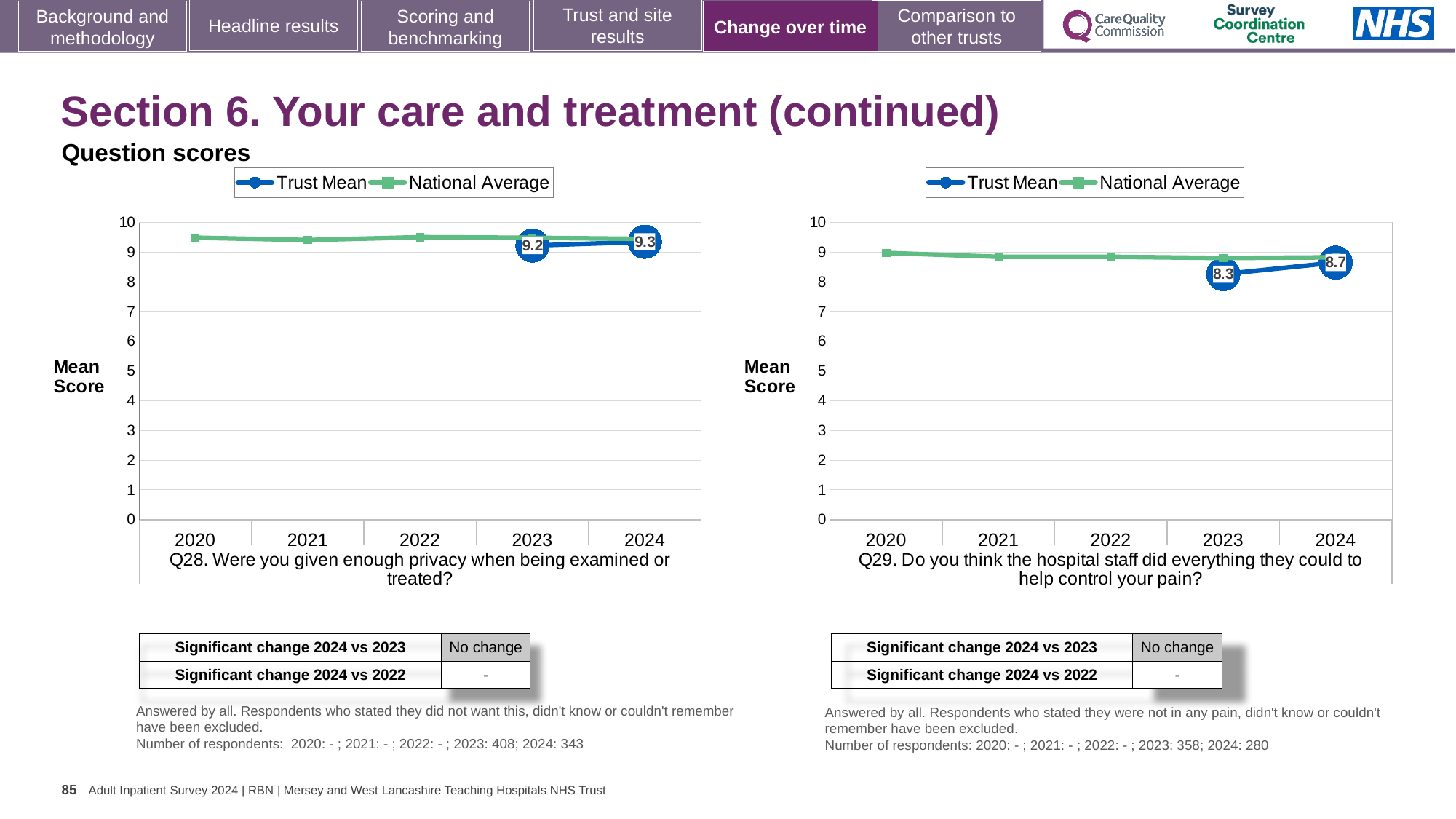
In the Q29 chart (right), which is larger in 2023: the Trust Mean or the National Average? National Average What kind of chart is used for Q28 (left)? line chart In the Q29 chart (right), is the National Average value for 2020 greater or less than 8? greater In the Q28 chart (left), by how much did the Trust Mean change from 2023 to 2024? 0.1 How many years are shown on the x axis of the Q28 chart (left)? 5 In the Q29 chart (right), what is the Trust Mean score for 2024? 8.7 How many series does the legend of the Q29 chart (right) list? 2 In the Q28 chart (left), what is the Trust Mean score for 2024? 9.3 In the Q29 chart (right), did the Trust Mean rise or fall from 2023 to 2024? rise In the Q28 chart (left), what is the Trust Mean score for 2023? 9.2 In the Q29 chart (right), what is the Trust Mean score for 2023? 8.3 In the Q29 chart (right), by how much did the Trust Mean change from 2023 to 2024? 0.4